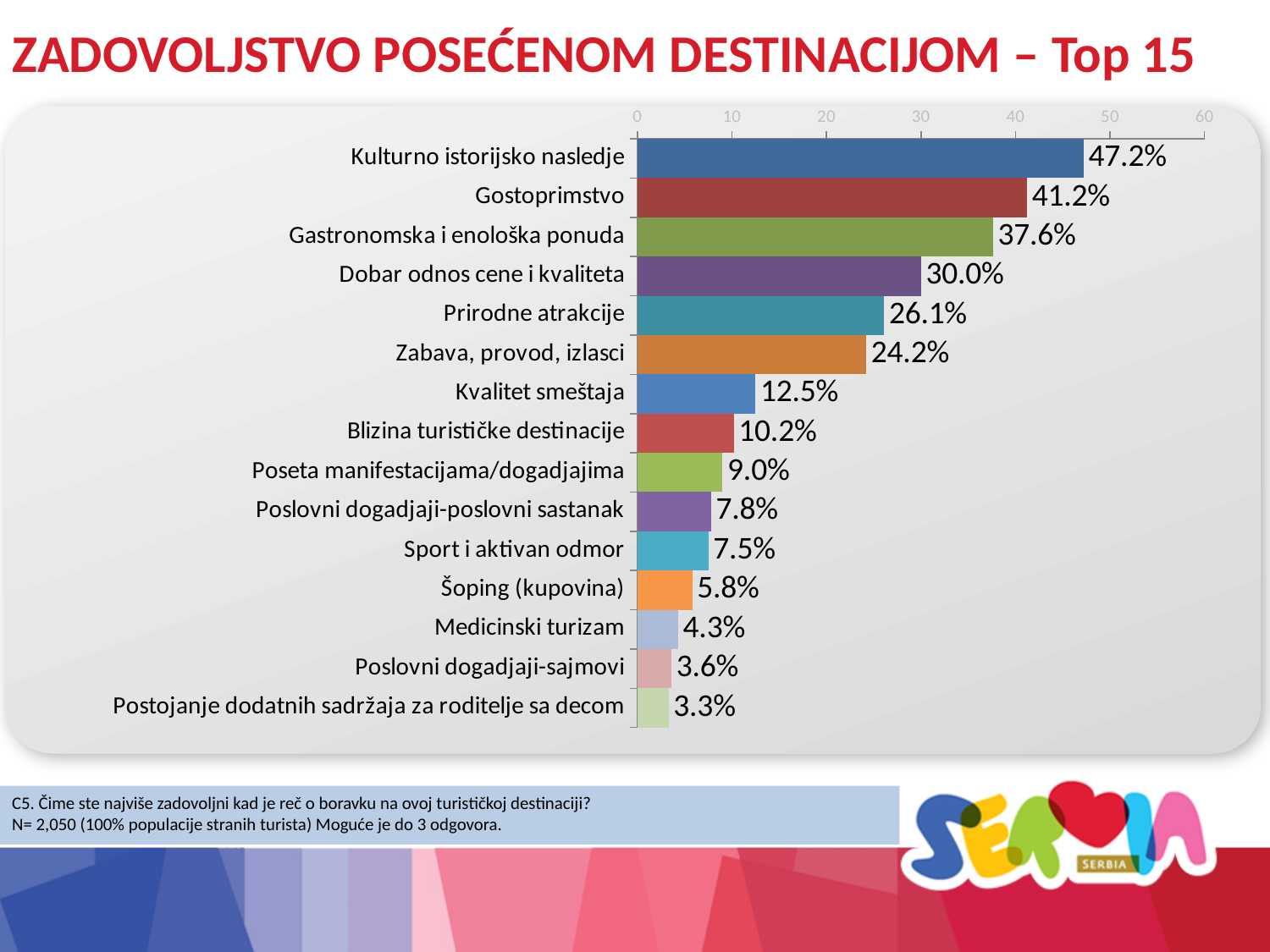
What is the value for Kulturno istorijsko nasledje? 47.2% What is the value for Prirodne atrakcije? 26.1% What kind of chart is shown on the slide? bar chart How many categories are shown in the chart? 15 Is the value for Dobar odnos cene i kvaliteta greater or less than 20? greater What is the difference between the values for Gostoprimstvo and Gastronomska i enološka ponuda? 3.6% What is the value for Medicinski turizam? 4.3% Which is larger, the value for Kvalitet smeštaja or the value for Blizina turističke destinacije? Kvalitet smeštaja Which category has the highest value? Kulturno istorijsko nasledje Which category has the lowest value? Postojanje dodatnih sadržaja za roditelje sa decom Do the values rise or fall going from the top category to the bottom category? fall What is the value for Šoping (kupovina)? 5.8%